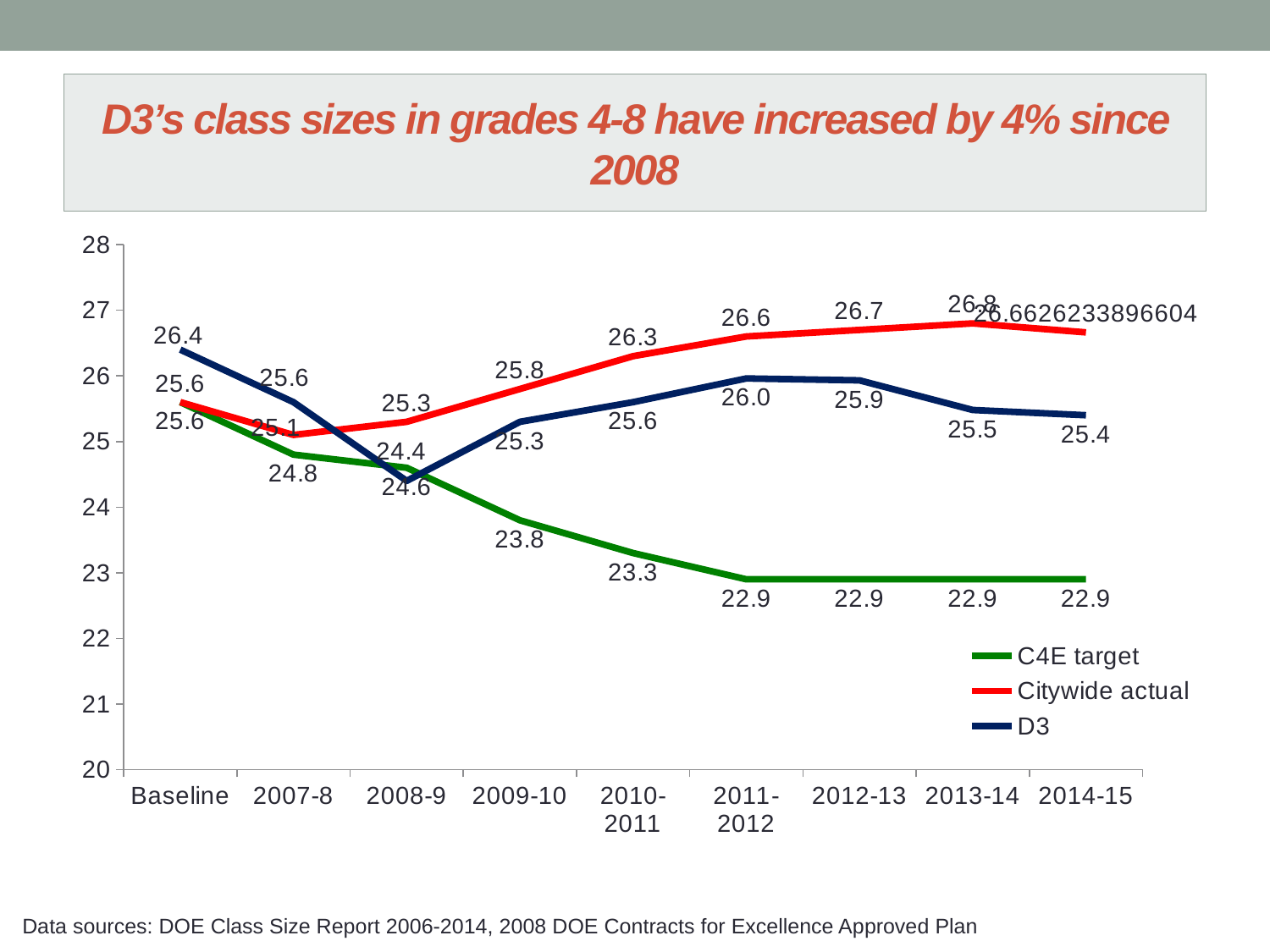
How many series does the legend list? 3 In which category is the D3 series at its lowest? 2008-9 In 2011-2012, which is larger: the Citywide actual value or the D3 value? Citywide actual What is the D3 value at Baseline? 26.4 What kind of chart is shown on the slide? Line chart What is the Citywide actual value for 2012-13? 26.7 What is the difference between the Citywide actual and C4E target values in 2013-14? 3.9 How many categories are shown along the x axis? 9 What is the D3 value for 2013-14? 25.5 Does the C4E target series rise or fall from Baseline to 2011-2012? Fall What is the C4E target value for 2010-2011? 23.3 In which category is the D3 series at its highest? Baseline